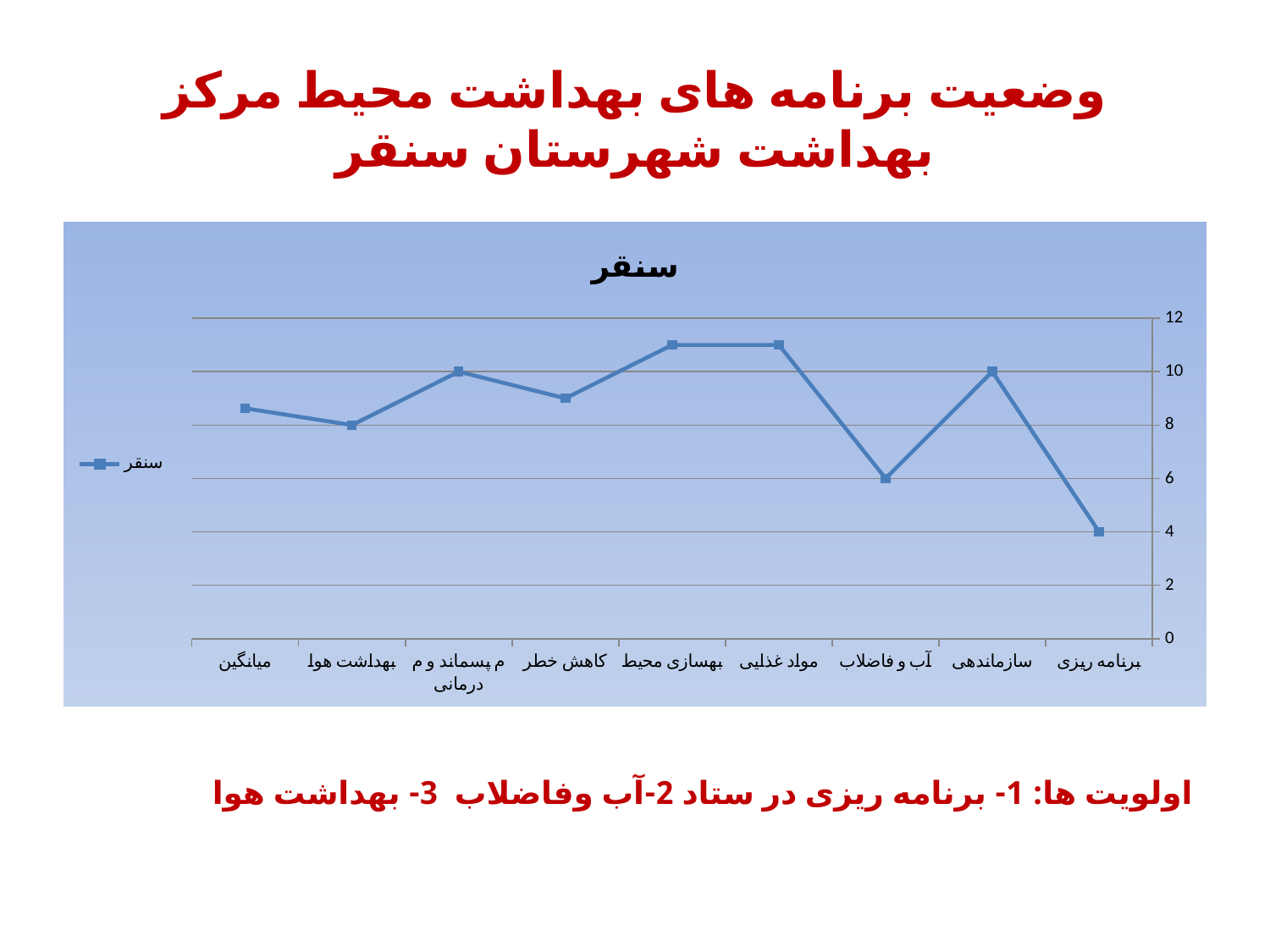
What is the value for سازماندهی? 10 How many categories are plotted along the x axis of the chart? 9 Which category has the lowest value? برنامه ریزی Is the value for مولد غذایی greater or less than 10? greater What is the value for برنامه ریزی? 4 How many series does the chart's legend list? 1 What is the value for بهداشت هوا? 8 What kind of chart is shown on the slide? line chart Which is larger, the value for سازماندهی or the value for آب و فاضلاب? سازماندهی What is the value for آب و فاضلاب? 6 What is the difference between the values for سازماندهی and برنامه ریزی? 6 Is the value for کاهش خطر greater or less than 8? greater